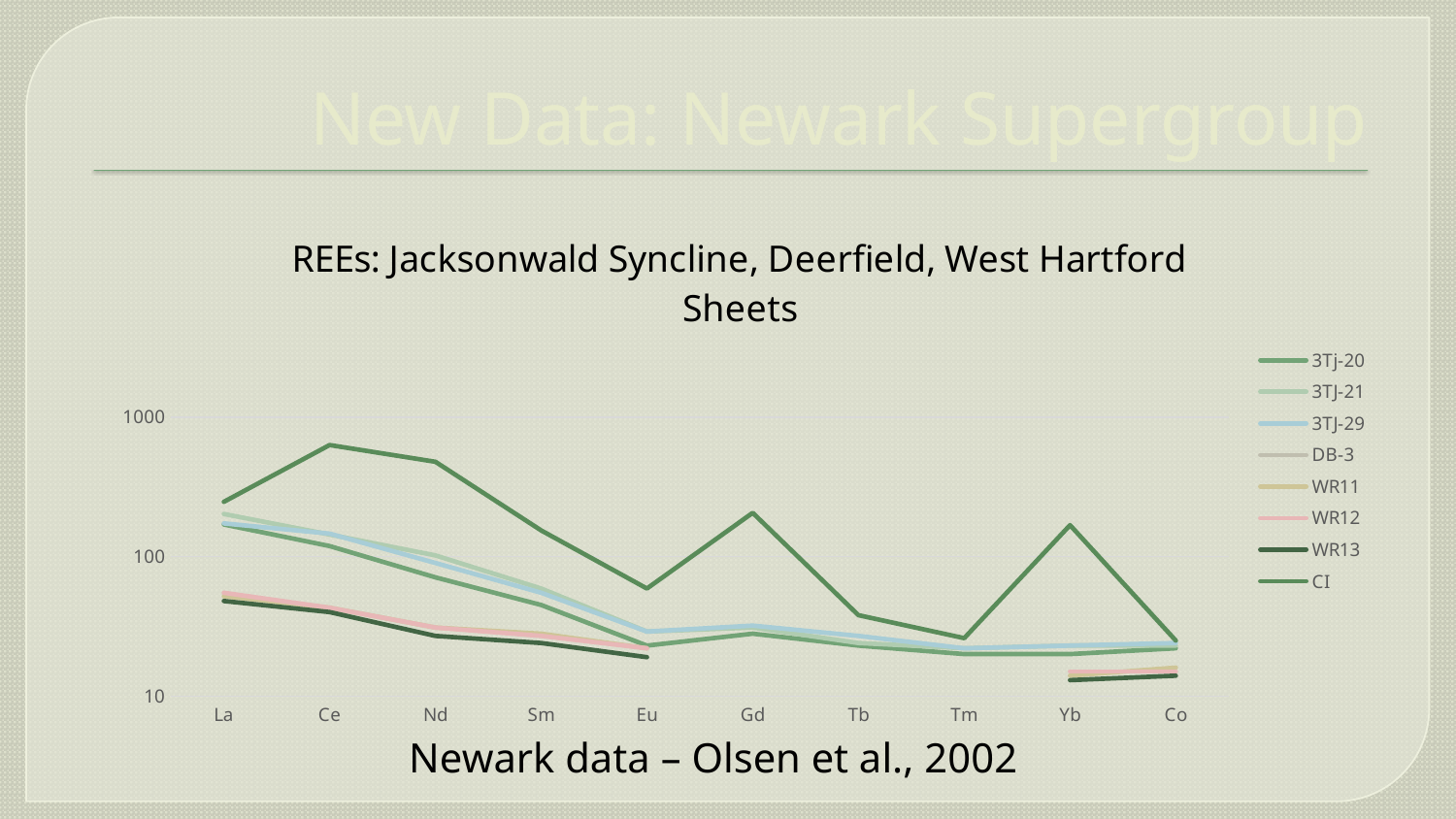
How many series does the legend list? 8 Is the value for CI at Ce greater or less than 100? greater Does the CI series rise or fall from Ce to Eu? fall What is the title of the chart? REEs: Jacksonwald Syncline, Deerfield, West Hartford Sheets At which category does the CI series reach its highest value? Ce Is the value for CI at Gd greater or less than 100? greater Is the value for CI at Eu greater or less than 100? less What kind of chart is shown on the slide? line chart How many categories are shown along the x axis? 10 Which series has the highest value at Ce? CI